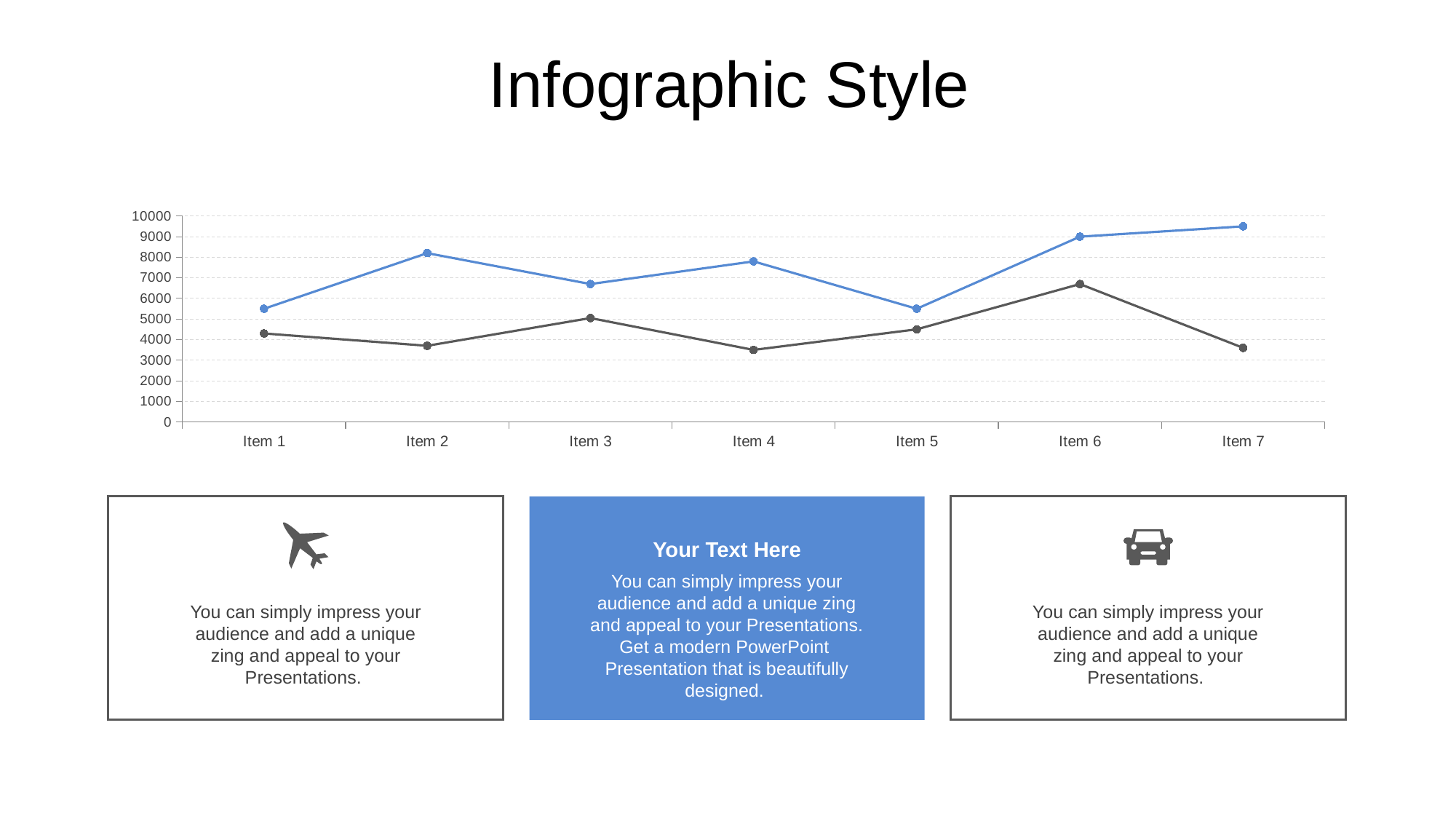
At Item 7, which line has the larger value, the blue line or the dark gray line? The blue line Is the value of the dark gray line at Item 7 greater or less than 4000? less For the dark gray line, which item has the highest value? Item 6 How many categories are plotted along the x axis of the chart? 7 Is the value of the blue line at Item 2 greater or less than 8000? greater For the dark gray line, which is larger, the value at Item 3 or the value at Item 4? Item 3 Is the value of the dark gray line at Item 6 greater or less than 6000? greater For the blue line, which item has the highest value? Item 7 How many lines (series) are plotted on the chart? 2 Does the blue line rise or fall from Item 5 to Item 7? Rise What kind of chart is shown on the slide? Line chart